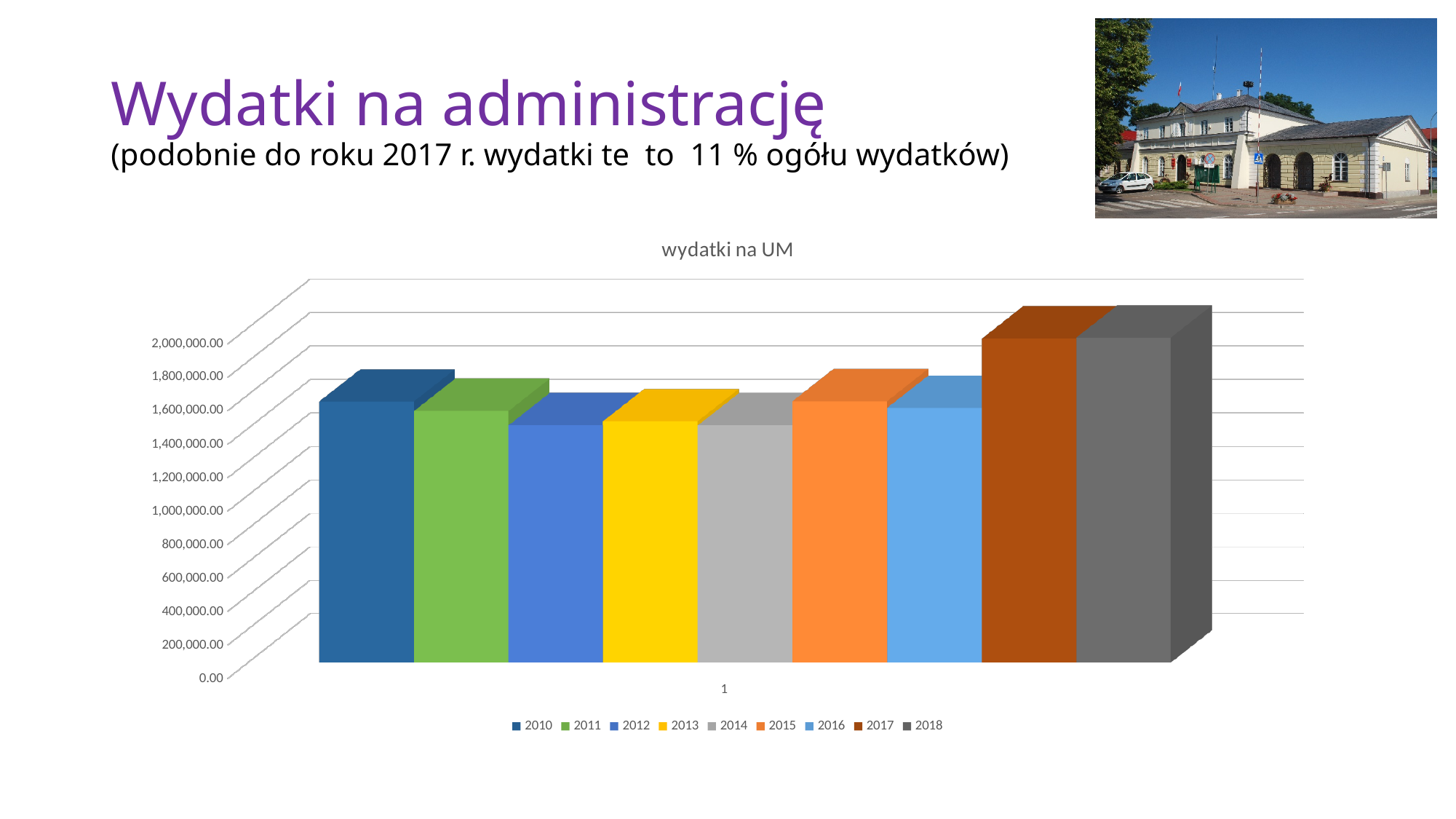
How many series does the legend of the chart list? 9 Is the value for 2010 greater or less than 1,400,000.00? greater Is the value for 2013 greater or less than 1,200,000.00? greater Is the value for 2014 greater or less than 1,800,000.00? less What kind of chart is shown on the slide? bar chart Which is larger, the value for 2010 or the value for 2013? 2010 Which is larger, the value for 2018 or the value for 2014? 2018 Which year is the first entry in the chart legend? 2010 What is the title of the chart? wydatki na UM Which is larger, the value for 2017 or the value for 2012? 2017